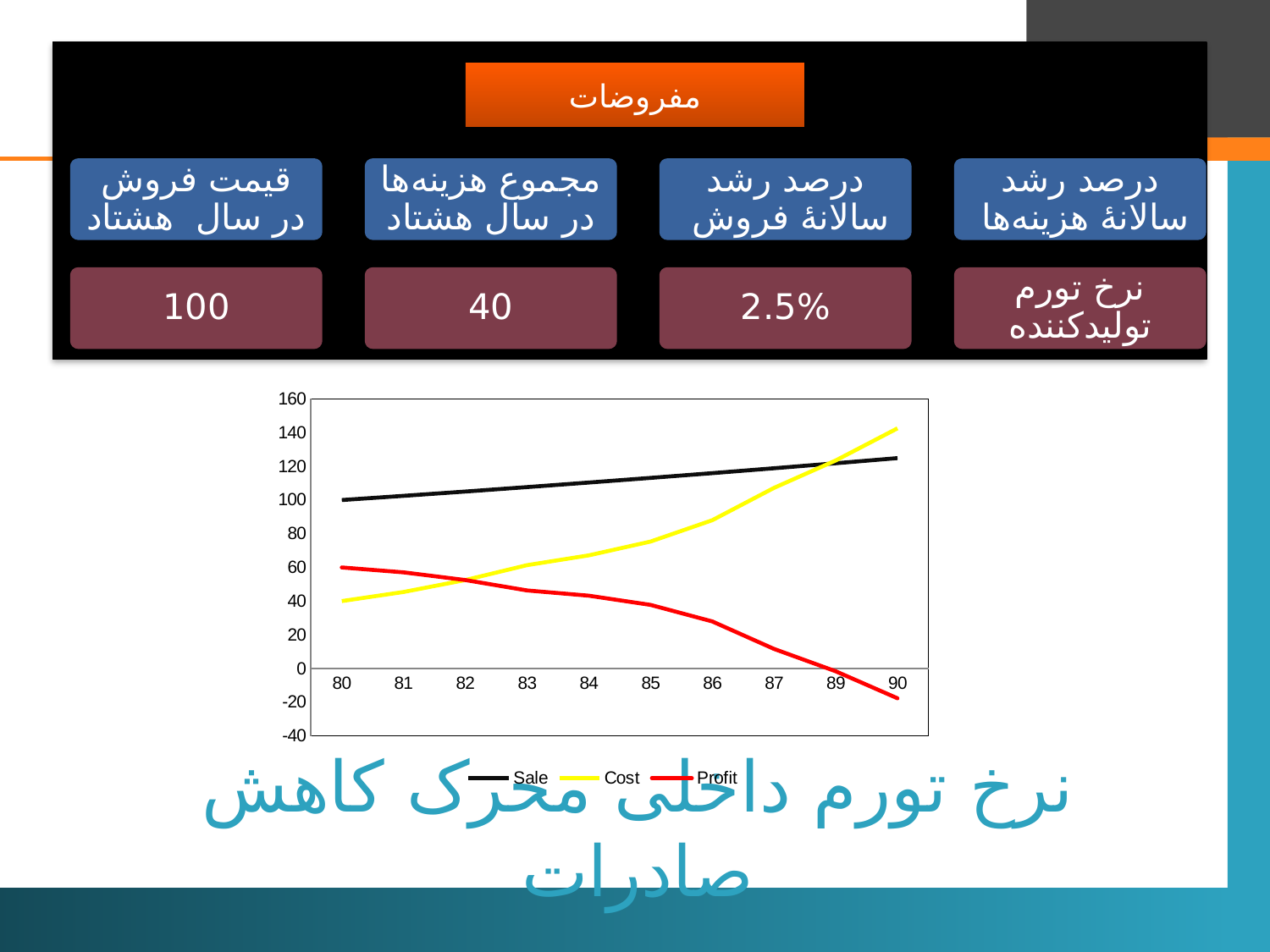
Is the value of Cost at 90 greater or less than 120? greater What is the value of Cost at 80? 40 How many series does the chart's legend list? 3 What is the value of Profit at 80? 60 What kind of chart is shown on the slide? line chart How many points are there along the x axis of the chart? 10 Is the value of Profit at 90 greater or less than 0? less Which series is drawn in red in the chart? Profit What is the value of Sale at 80? 100 Does the Sale series rise or fall from 80 to 90? rise At 90, which is larger, Cost or Sale? Cost Does the Profit series rise or fall from 80 to 90? fall